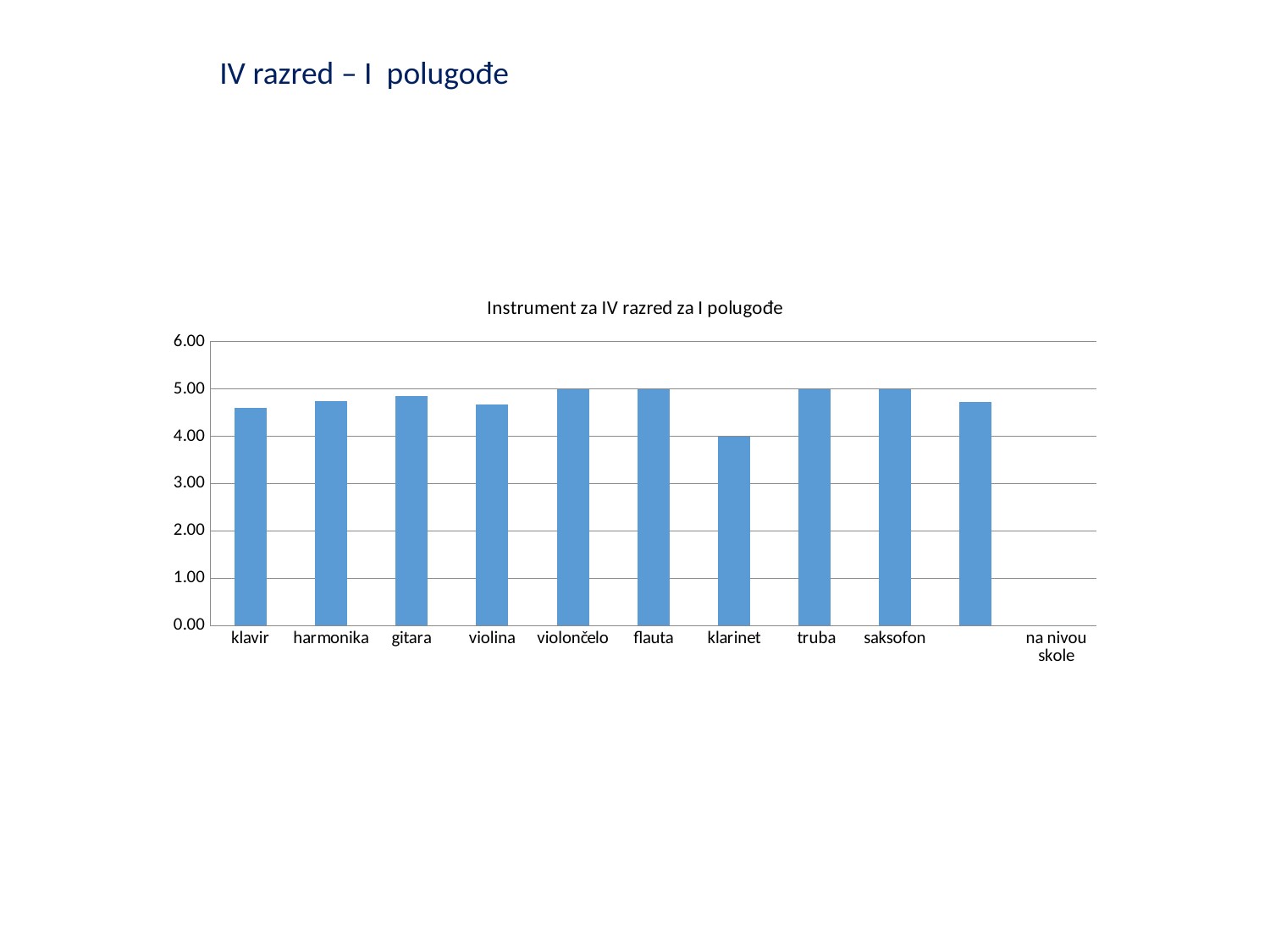
Which is larger, the value for gitara or the value for klavir? gitara Is the value for klavir greater or less than 5.00? less What kind of chart is shown on the slide? bar chart What is the title of the chart? Instrument za IV razred za I polugođe Which is larger, the value for klavir or the value for klarinet? klavir What is the value for flauta? 5.00 Is the value for gitara greater or less than 5.00? less Is the value for harmonika greater or less than 4.00? greater What colour are the bars in the chart? blue Which is larger, the value for truba or the value for klarinet? truba What is the value for klarinet? 4.00